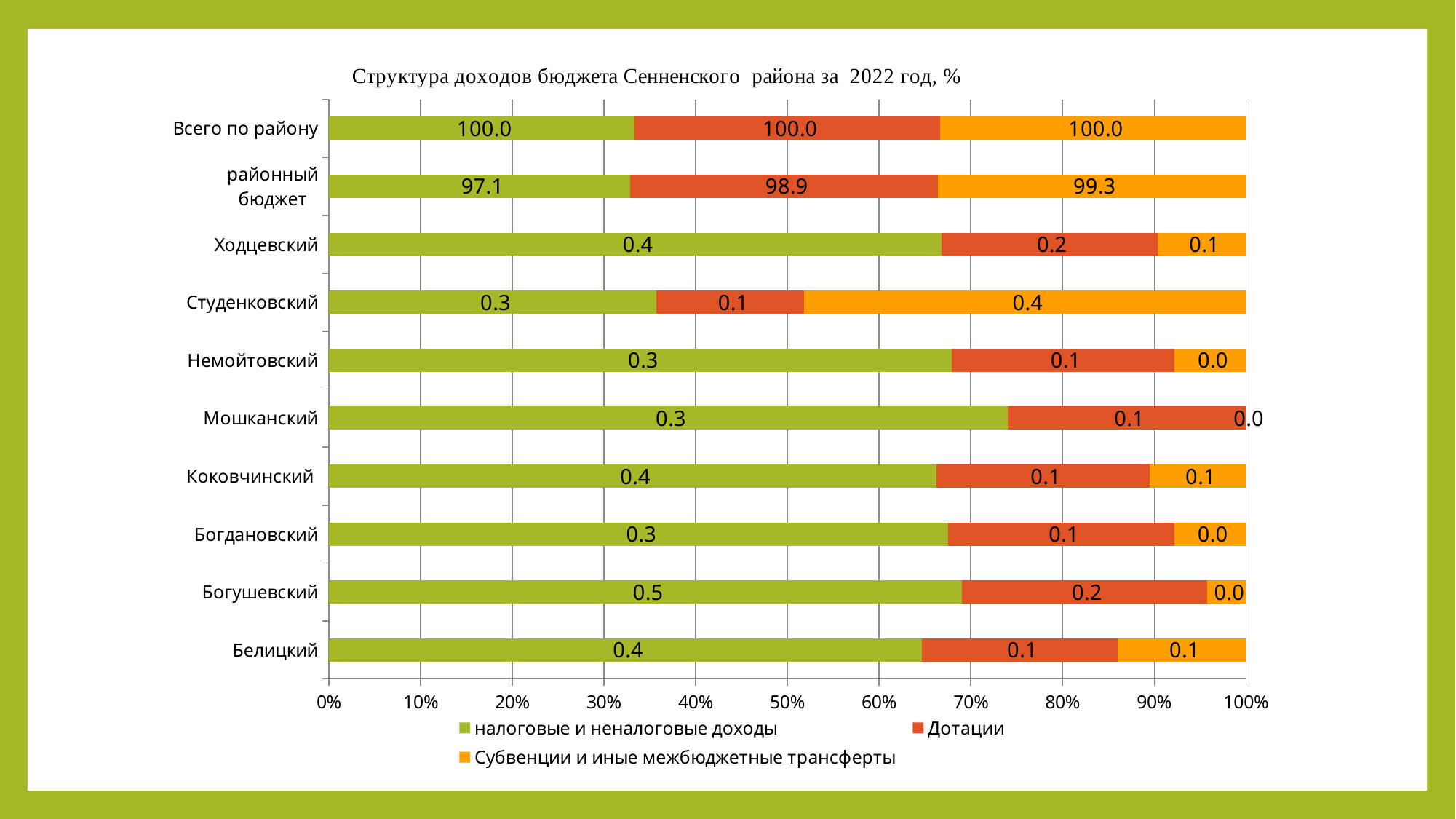
What is the value of 'налоговые и неналоговые доходы' for 'Богушевский'? 0.5 What is the value of 'Дотации' for 'Ходцевский'? 0.2 What is the value of 'налоговые и неналоговые доходы' for 'районный бюджет'? 97.1 What is the value of 'Субвенции и иные межбюджетные трансферты' for 'Студенковский'? 0.4 What is the difference between the 'Субвенции и иные межбюджетные трансферты' value and the 'налоговые и неналоговые доходы' value for 'районный бюджет'? 2.2 What type of chart is shown on the slide? stacked bar chart How many categories are shown on the vertical axis? 10 Is the share of the bar taken by 'налоговые и неналоговые доходы' for 'Мошканский' greater or less than 70%? greater Among the rural councils (excluding 'Всего по району' and 'районный бюджет'), which has the highest labelled value for 'налоговые и неналоговые доходы'? Богушевский What is the title of the chart? Структура доходов бюджета Сенненского района за 2022 год, % Which is larger for 'Студенковский': the 'налоговые и неналоговые доходы' value or the 'Субвенции и иные межбюджетные трансферты' value? Субвенции и иные межбюджетные трансферты How many series does the legend list? 3